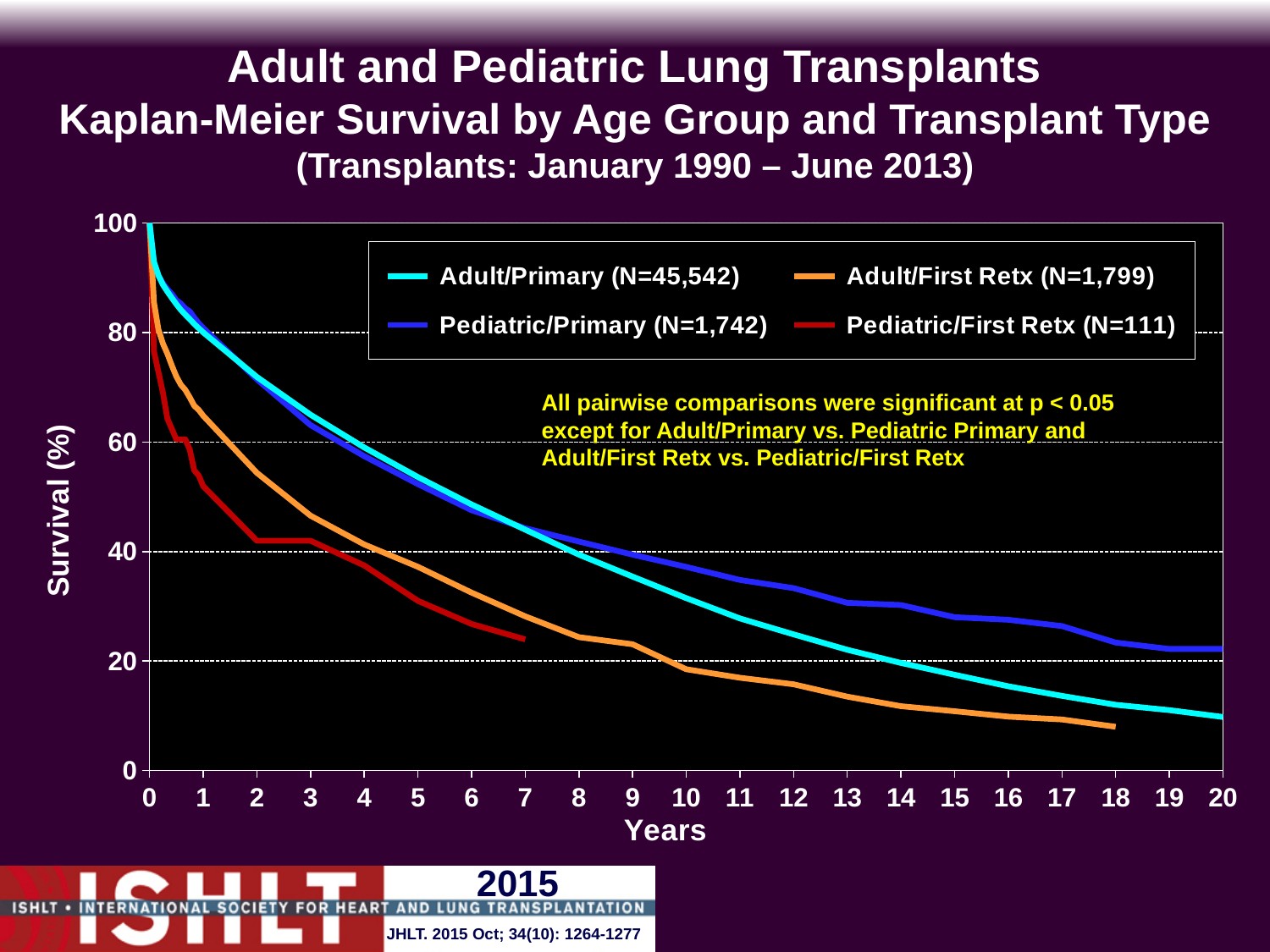
Is the survival value for Adult/Primary at 10 years greater or less than 20? greater What kind of chart is shown on the slide? line chart How many series does the legend list? 4 Which series has the lowest survival at 5 years? Pediatric/First Retx Is the survival value for Pediatric/First Retx at 7 years greater or less than 40? less At 5 years, which has higher survival: Adult/First Retx or Pediatric/First Retx? Adult/First Retx Is the survival value for Adult/Primary at 10 years greater or less than 40? less What is the N for the Pediatric/First Retx group shown in the legend? 111 At 15 years, which has higher survival: Adult/Primary or Pediatric/Primary? Pediatric/Primary Do the survival curves rise or fall as years increase? fall What is the N for the Adult/Primary group shown in the legend? 45,542